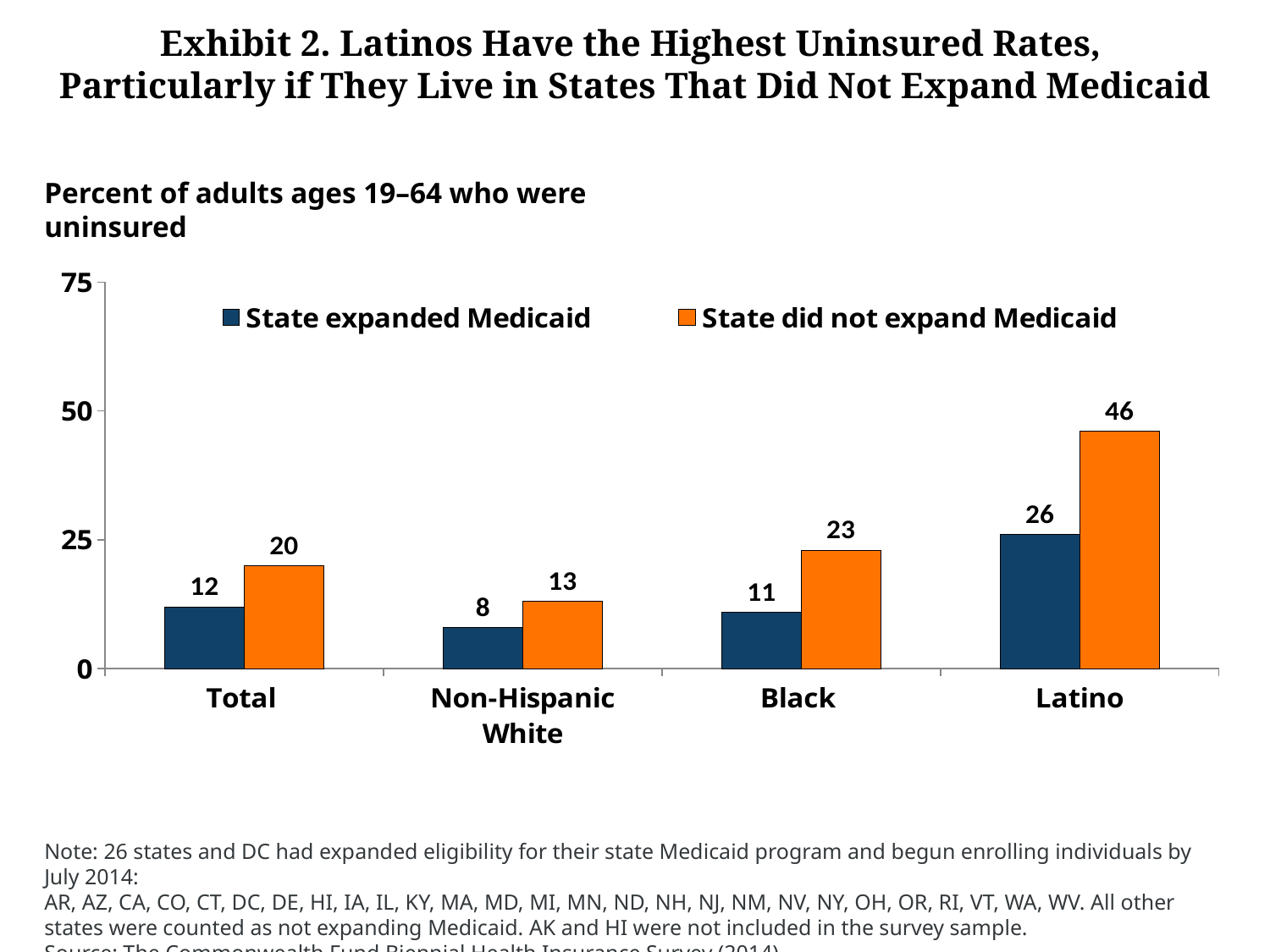
Which group has the lowest uninsured rate in states that expanded Medicaid? Non-Hispanic White What is the value for Black adults in states that did not expand Medicaid? 23 What is the difference between the Latino uninsured rates in states that did not expand Medicaid and states that did? 20 Is the value for Latinos in states that did not expand Medicaid greater or less than 25? greater What kind of chart is shown on the slide? Bar chart Which colour represents states that did not expand Medicaid? Orange Which group has the highest uninsured rate in states that did not expand Medicaid? Latino How many series does the legend list? 2 What is the uninsured rate for Latinos in states that did not expand Medicaid? 46 What is the uninsured rate for Non-Hispanic White adults in states that expanded Medicaid? 8 Which is larger: the Total value for states that did not expand Medicaid or the Black value for states that expanded Medicaid? Total value for states that did not expand Medicaid How many groups are shown on the x axis? 4